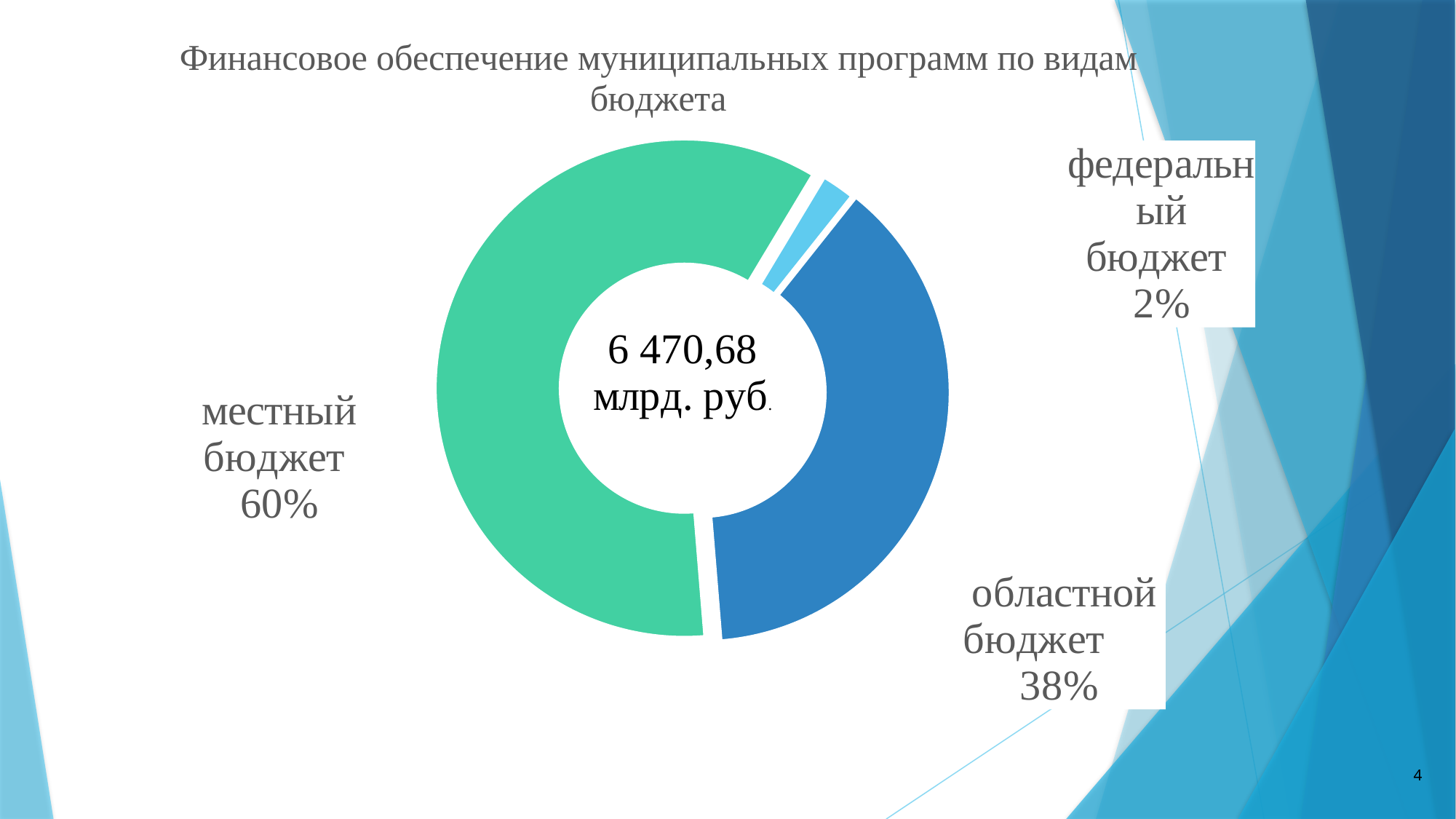
What share of the chart does областной бюджет account for? 38% Which budget type has the largest share in the chart? местный бюджет Which has a larger share, областной бюджет or федеральный бюджет? областной бюджет What total amount is printed in the centre of the chart? 6 470,68 млрд. руб. What share of the chart does федеральный бюджет account for? 2% What share of the chart does местный бюджет account for? 60% How many budget types (slices) are shown in the chart? 3 Which budget type has the smallest share in the chart? федеральный бюджет What is the difference in percentage points between the shares of областной бюджет and федеральный бюджет? 36 What is the difference in percentage points between the shares of местный бюджет and областной бюджет? 22 What kind of chart is shown on the slide? doughnut chart What is the title of the chart? Финансовое обеспечение муниципальных программ по видам бюджета